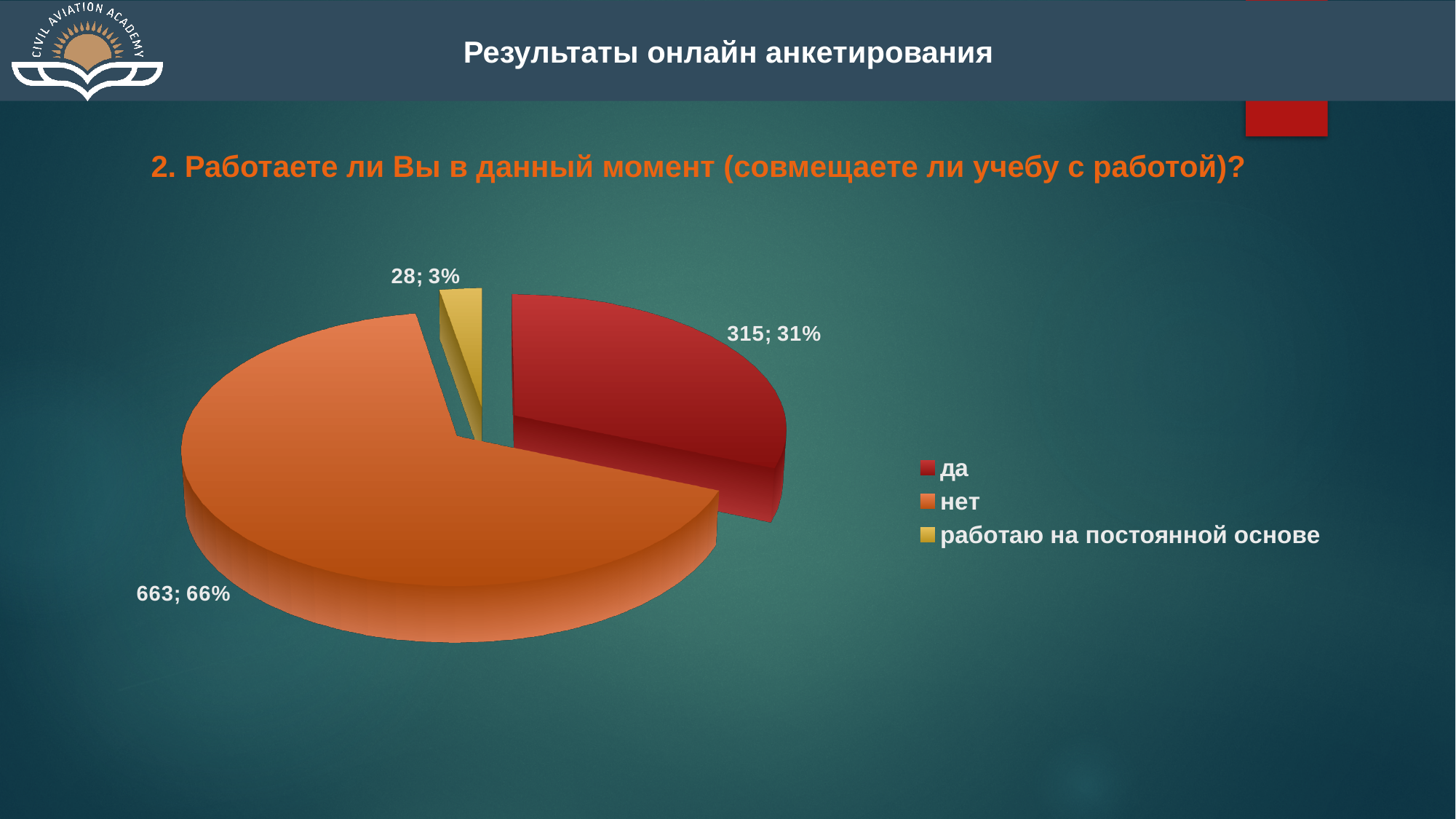
What is the count for the "да" slice? 315 What is the difference between the counts for "нет" and "да"? 348 What share of the pie does the "нет" slice represent? 66% What is the count for the "нет" slice? 663 What share of the pie does the "да" slice represent? 31% How many slices does the pie chart have? 3 How many entries does the legend list? 3 Which colour represents the "да" category in the legend? red Which category has the smallest slice? работаю на постоянной основе Which category has the largest slice? нет What kind of chart is shown on the slide? pie chart What is the count for the "работаю на постоянной основе" slice? 28